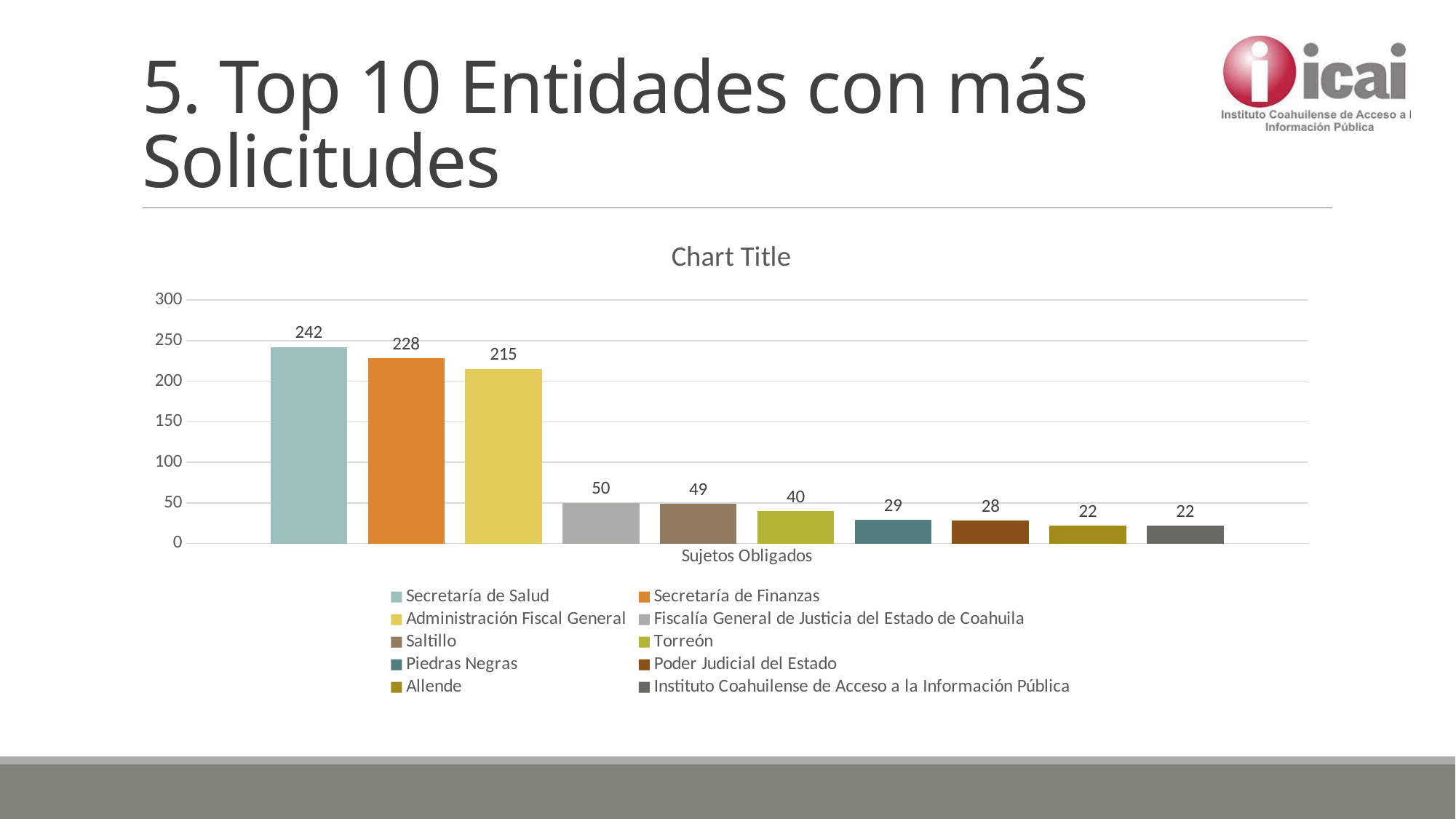
What is the difference between the values for Secretaría de Finanzas and Administración Fiscal General? 13 Is the value for Secretaría de Finanzas greater or less than 200? greater How many entries does the legend list? 10 Which is larger, the value for Saltillo or the value for Torreón? Saltillo What type of chart is shown on the slide? Bar chart What is the value for Poder Judicial del Estado? 28 What is the difference between the values for Fiscalía General de Justicia del Estado de Coahuila and Piedras Negras? 21 What is the value for Administración Fiscal General? 215 Which entity has the highest value? Secretaría de Salud What is the value for Secretaría de Salud? 242 What is the value for Torreón? 40 How many bars are plotted in the chart? 10